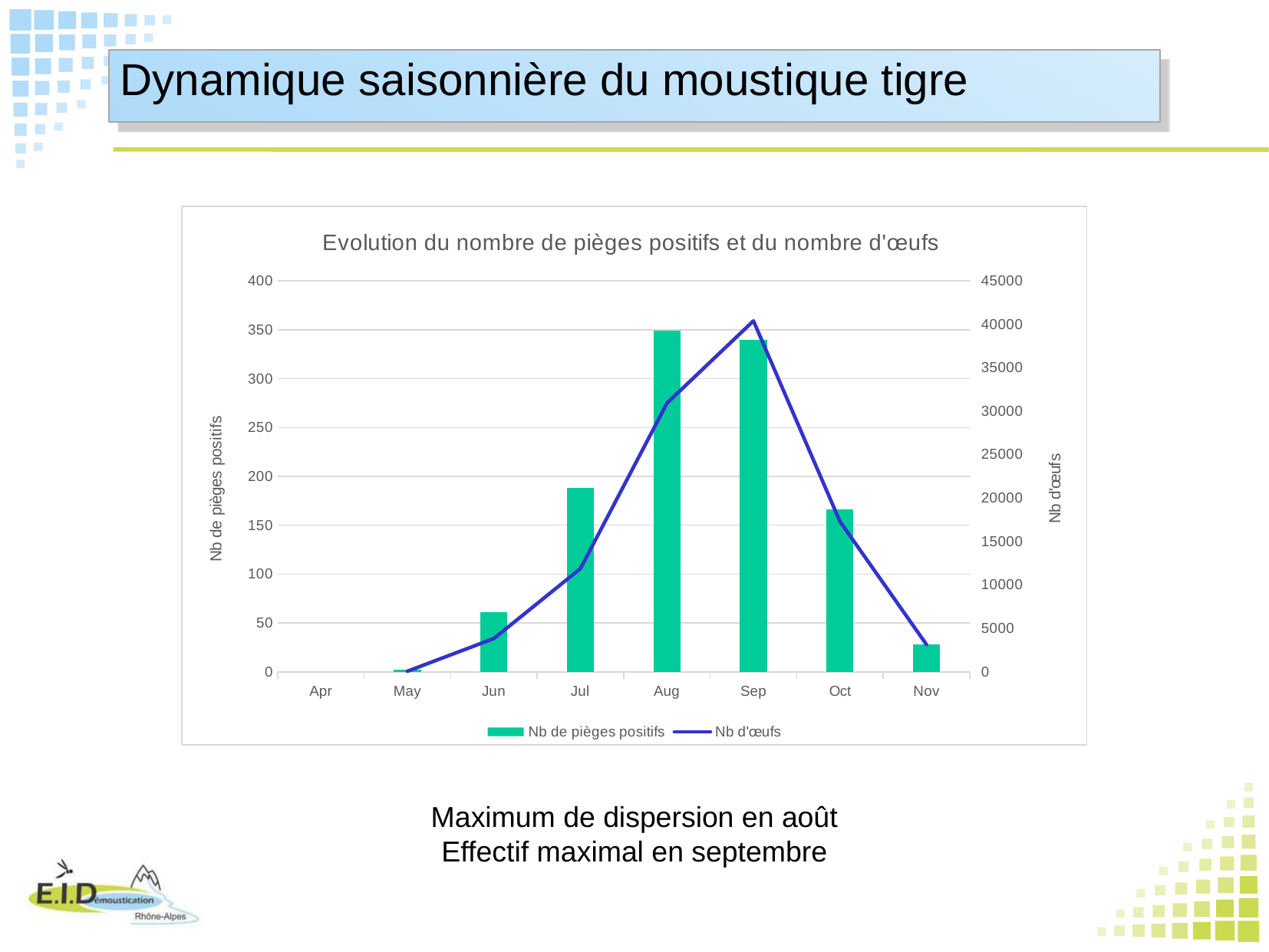
Which month has more positive traps, Jul or Oct? Jul How many months are shown on the x axis of the chart? 8 Is the value for Nb de pièges positifs in Nov greater or less than 50? less What kind of chart is shown on the slide? A bar chart combined with a line chart How many series does the chart legend list? 2 What is the title of the chart? Evolution du nombre de pièges positifs et du nombre d'œufs Is the value for Nb de pièges positifs in Oct greater or less than 200? less Is the value for Nb de pièges positifs in Jul greater or less than 150? greater In which month is the number of positive traps (Nb de pièges positifs) highest? Aug In which month does the number of eggs (Nb d'œufs) line reach its peak? Sep Does the number of eggs (Nb d'œufs) rise or fall from Sep to Nov? Fall